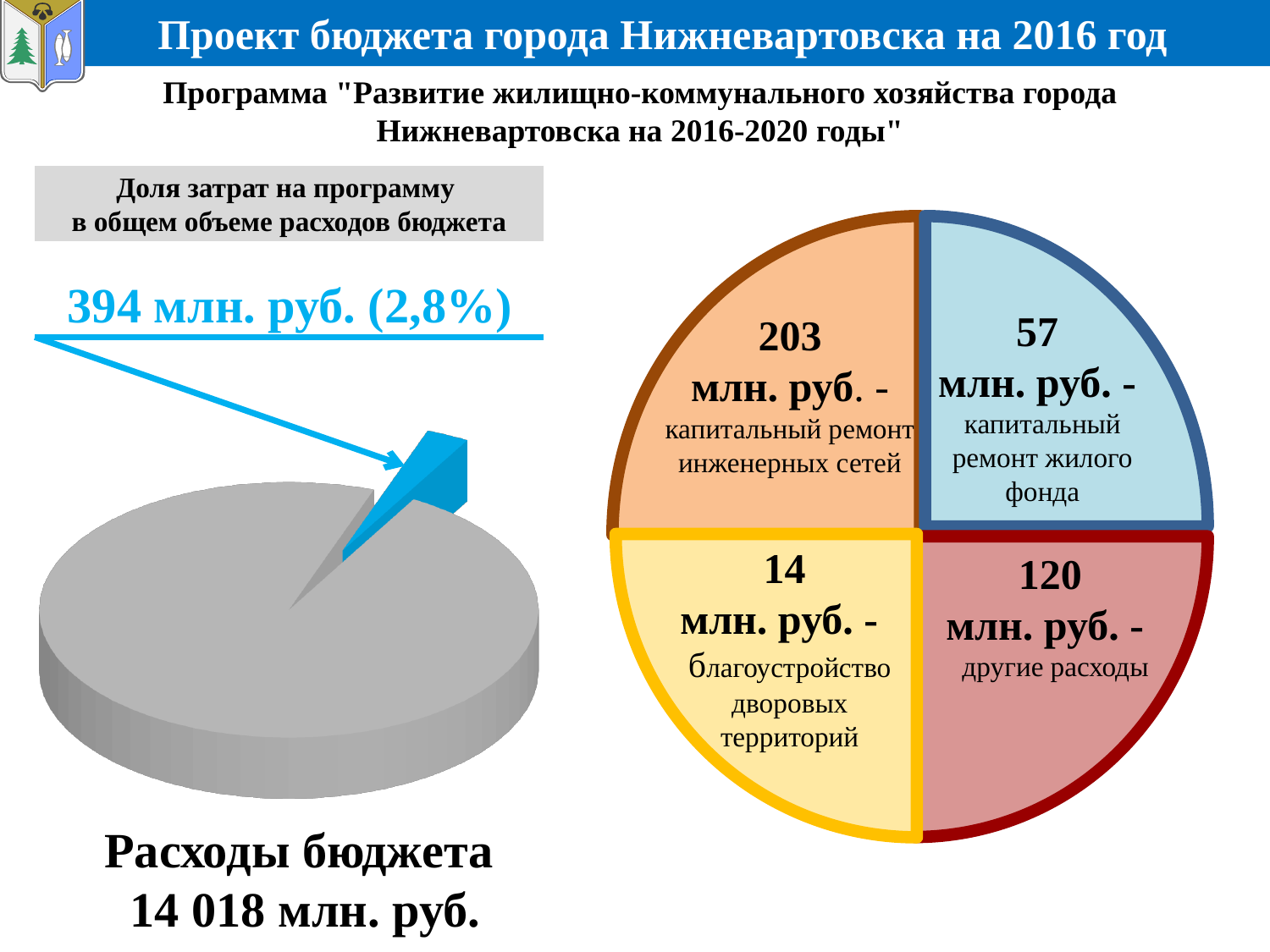
In the right pie chart, which is larger: другие расходы or капитальный ремонт жилого фонда? другие расходы In the right pie chart, which category has the lowest value? благоустройство дворовых территорий What kind of chart is shown on the left side of the slide, below the text "394 млн. руб. (2,8%)"? pie chart In the right pie chart, what is the value for другие расходы? 120 млн. руб. In the left pie chart, what value and share does the highlighted blue slice represent? 394 млн. руб. (2,8%) In the right pie chart, what is the difference between the values for капитальный ремонт инженерных сетей and другие расходы? 83 млн. руб. What kind of chart is shown on the right side of the slide? pie chart In the right pie chart, what is the value for капитальный ремонт жилого фонда? 57 млн. руб. In the right pie chart, which category has the highest value? капитальный ремонт инженерных сетей In the right pie chart, what is the value for благоустройство дворовых территорий? 14 млн. руб. How many segments does the right pie chart have? 4 In the right pie chart, what is the value for капитальный ремонт инженерных сетей? 203 млн. руб.